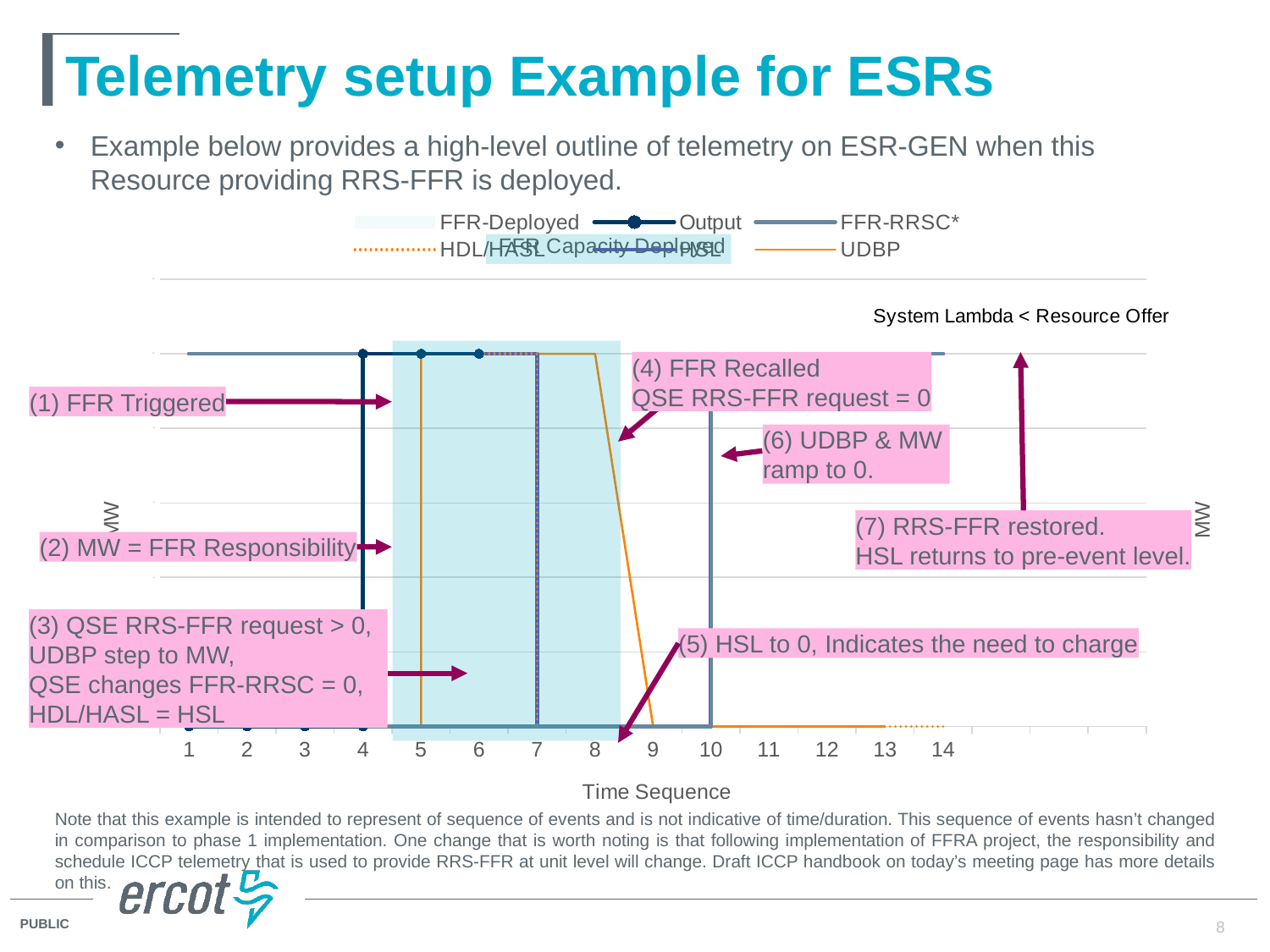
What is the label of the x axis? Time Sequence What kind of chart is shown on the slide? combination bar and line chart Does the UDBP series rise or fall between time sequence 8 and time sequence 9? fall Which series in the legend is drawn with a dotted line? HDL/HASL Does the Output series rise or fall at time sequence 4? rise How many time sequence points are labelled on the x axis? 14